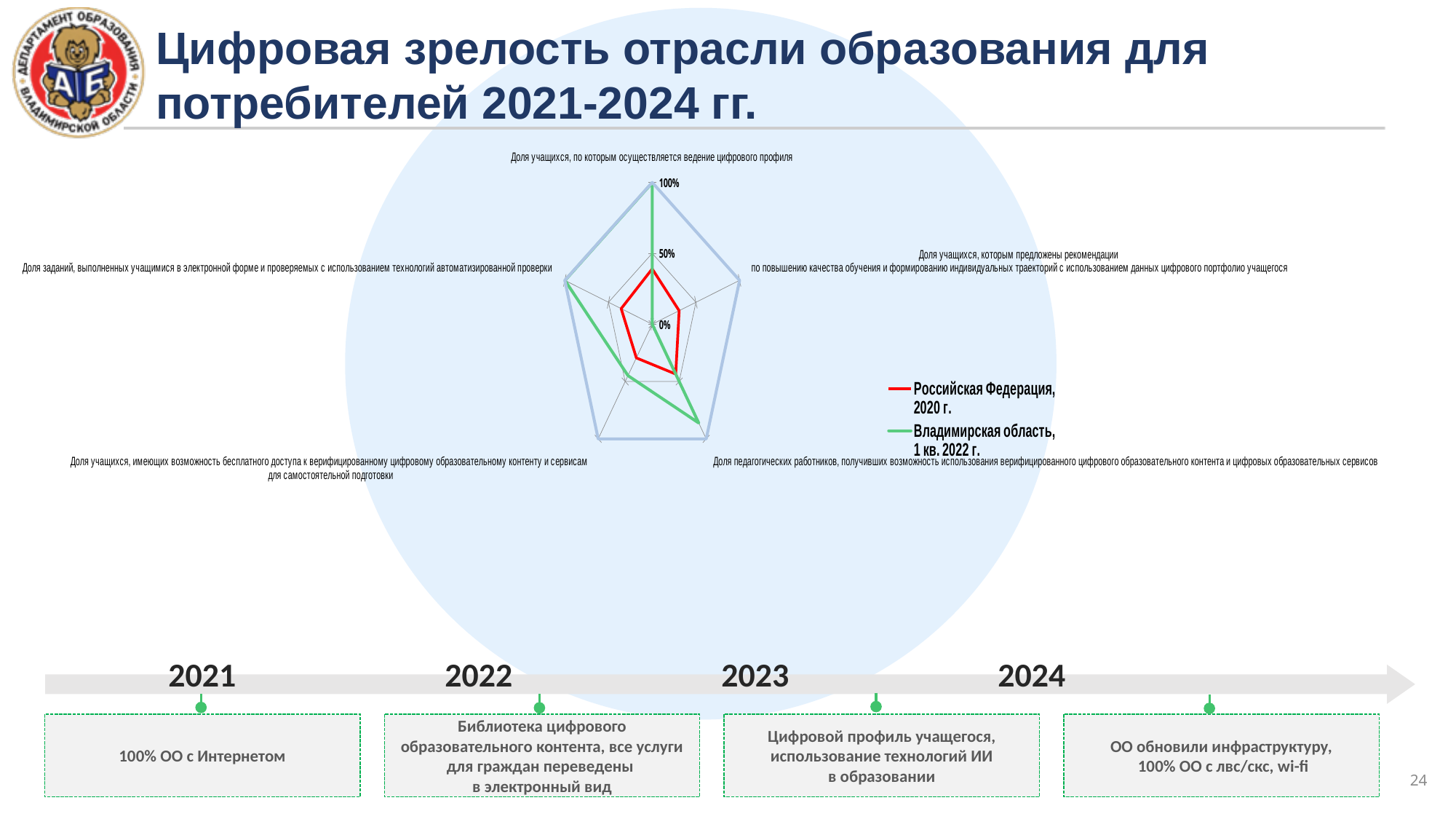
Which series is drawn in red on the radar chart? Российская Федерация, 2020 г. On the axis 'Доля учащихся, по которым осуществляется ведение цифрового профиля', which series has the larger value? Владимирская область, 1 кв. 2022 г. How many axes (categories) does the radar chart have? 5 On the axis 'Доля учащихся, которым предложены рекомендации по повышению качества обучения...', which series has the larger value? Российская Федерация, 2020 г. Is the value for Владимирская область, 1 кв. 2022 г. on the axis 'Доля заданий, выполненных учащимися в электронной форме и проверяемых с использованием технологий автоматизированной проверки' greater or less than 50%? greater What kind of chart is shown on the slide? Radar chart Which series is drawn in green on the radar chart? Владимирская область, 1 кв. 2022 г. Is the value for Российская Федерация, 2020 г. on the axis 'Доля педагогических работников, получивших возможность использования верифицированного цифрового образовательного контента...' greater or less than 100%? less How many series does the chart legend list? 2 Is the value for Российская Федерация, 2020 г. on the axis 'Доля учащихся, по которым осуществляется ведение цифрового профиля' greater or less than 50%? less